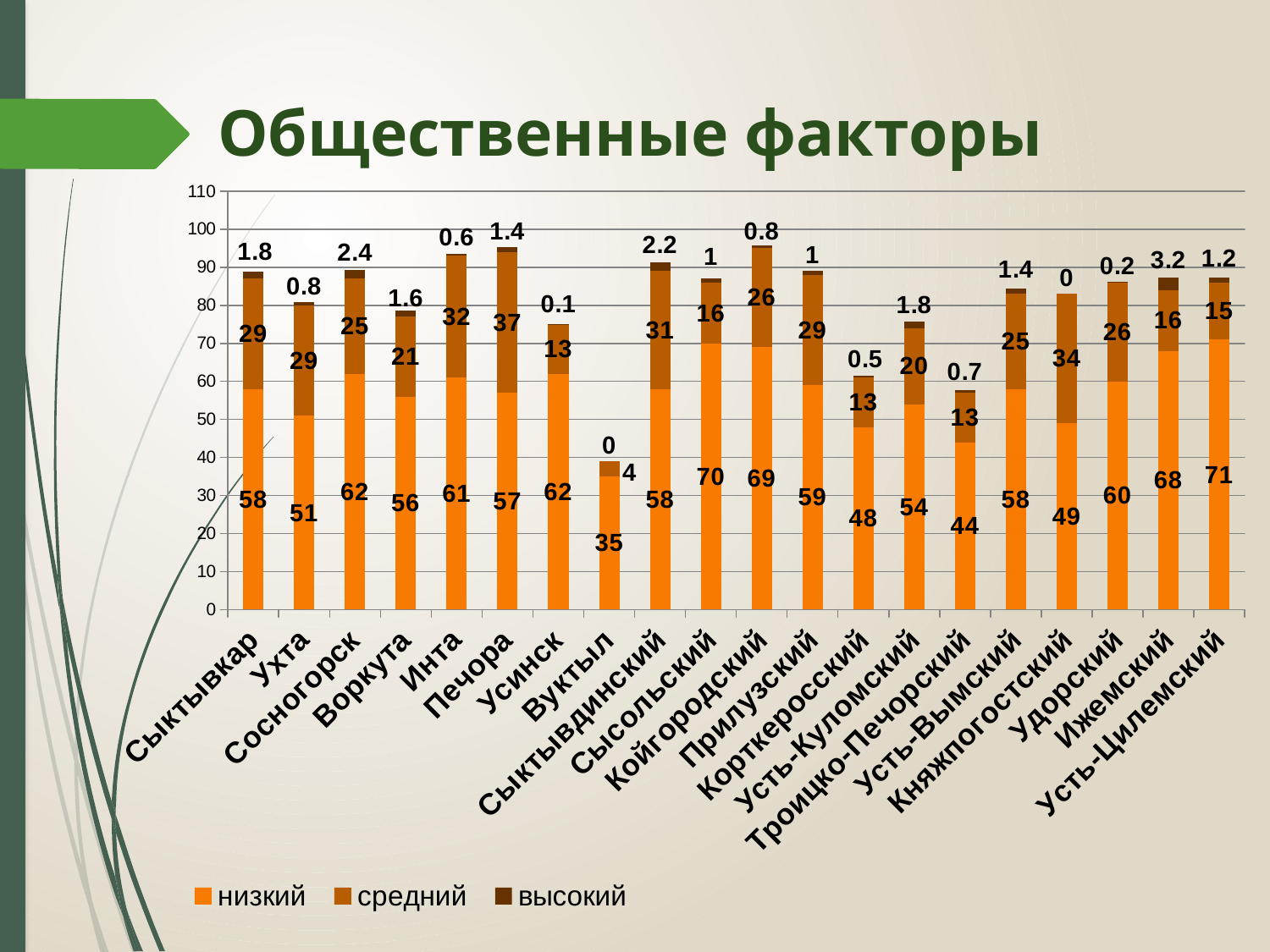
How many categories are shown on the x axis? 20 What is the value of the средний series for Печора? 37 What is the value of the высокий series for Ижемский? 3.2 What kind of chart is shown on the slide? stacked bar chart Which is larger, the средний value for Княжпогостский or for Удорский? Княжпогостский What is the value of the низкий series for Вуктыл? 35 What is the total of the stacked bar for Вуктыл? 39 What is the title of the chart? Общественные факторы Which category has the highest value in the низкий series? Усть-Цилемский How many series does the legend list? 3 What is the difference between the низкий values for Сысольский and Корткеросский? 22 Which category has the lowest value in the низкий series? Вуктыл